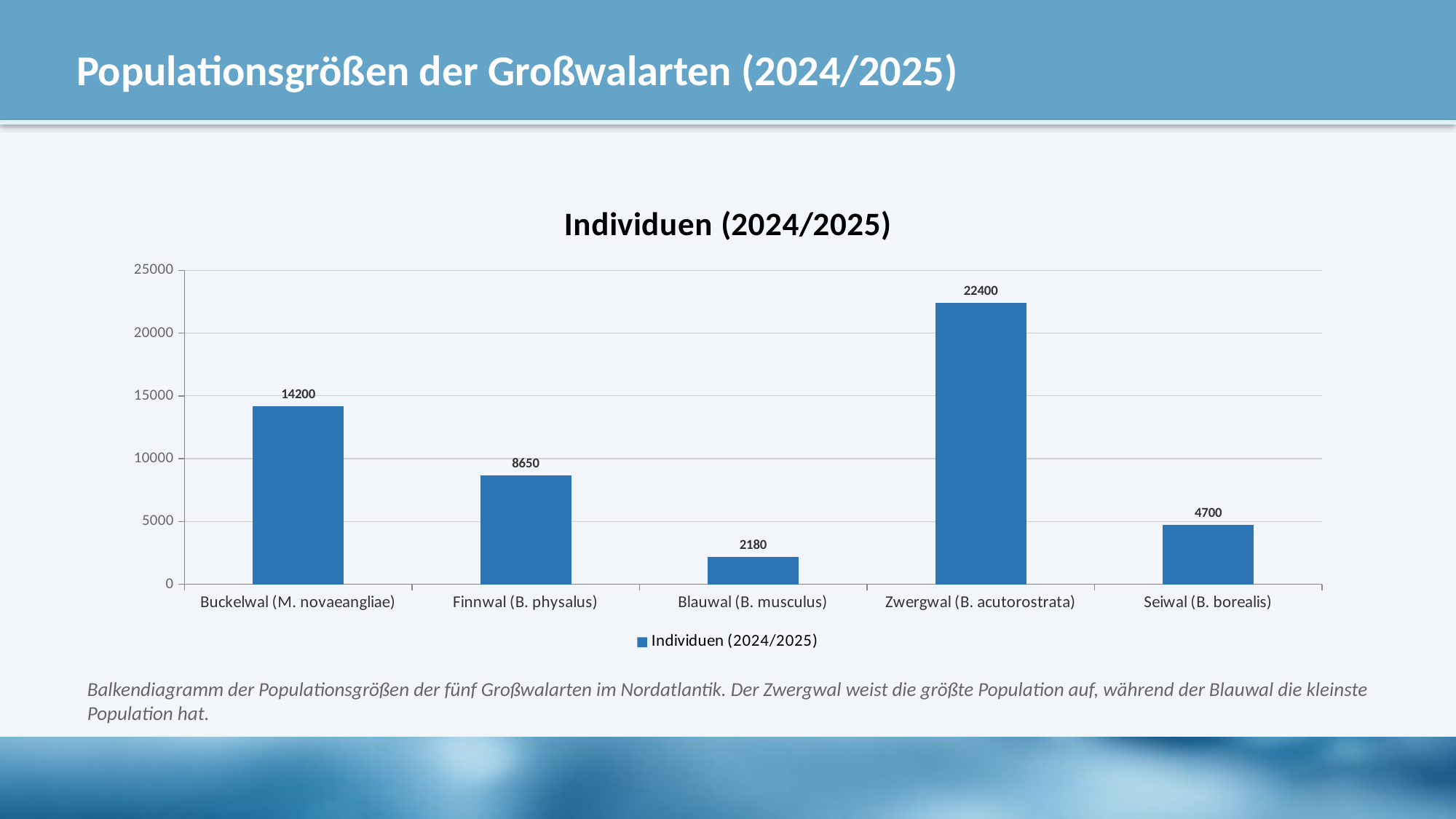
What is the difference between the values for Zwergwal (B. acutorostrata) and Buckelwal (M. novaeangliae)? 8200 What is the title of the chart? Individuen (2024/2025) Which category has the highest value? Zwergwal (B. acutorostrata) What is the value for Buckelwal (M. novaeangliae)? 14200 Is the value for Zwergwal (B. acutorostrata) greater or less than 20000? greater What kind of chart is shown on the slide? bar chart Which category has the lowest value? Blauwal (B. musculus) Which is larger, the value for Finnwal (B. physalus) or the value for Seiwal (B. borealis)? Finnwal (B. physalus) How many categories are shown on the x axis? 5 What is the value for Seiwal (B. borealis)? 4700 What is the value for Blauwal (B. musculus)? 2180 What is the difference between the values for Finnwal (B. physalus) and Seiwal (B. borealis)? 3950